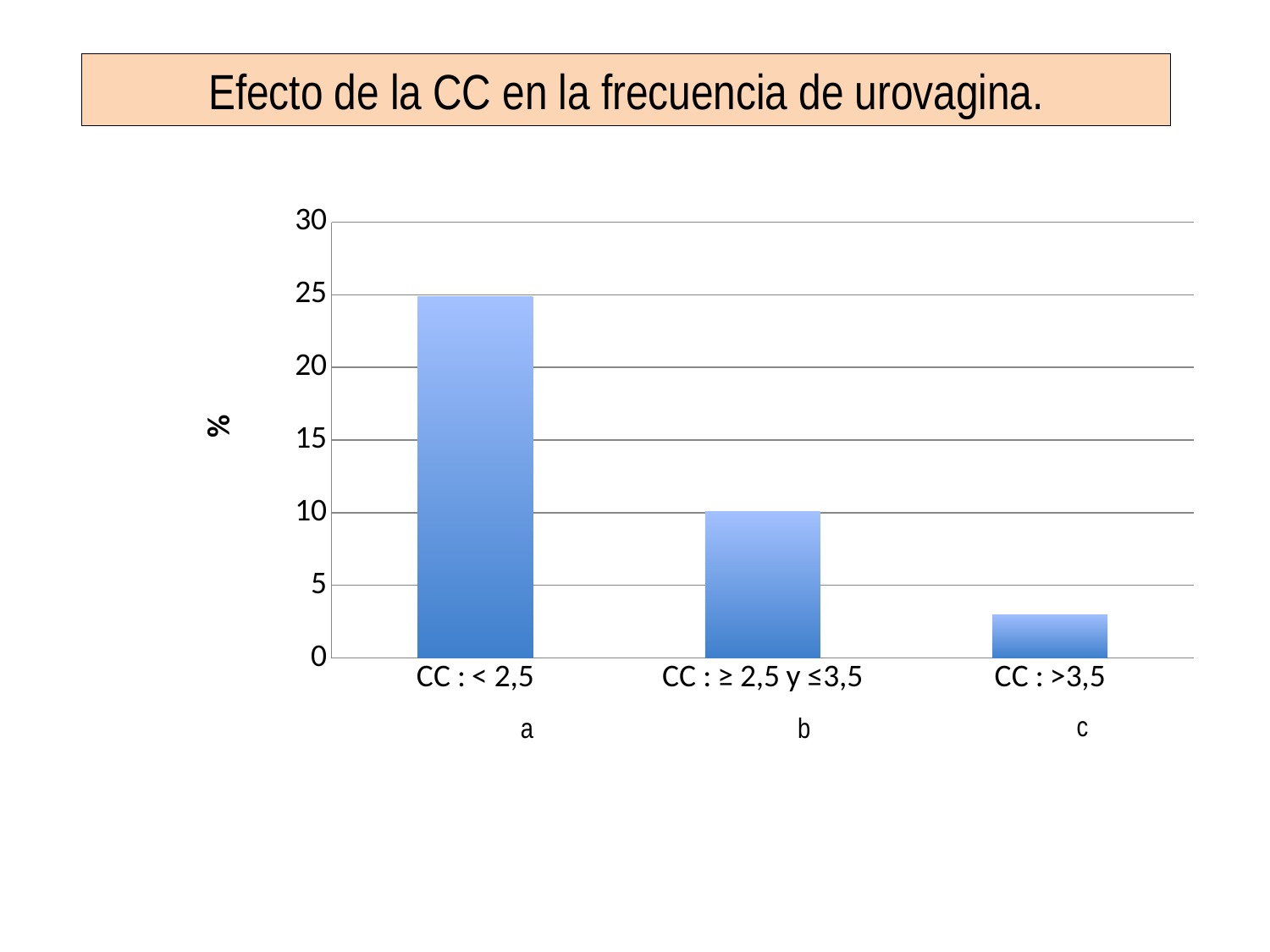
Is the value for CC : < 2,5 greater or less than 20? greater Which is larger, the value for CC : < 2,5 or the value for CC : ≥ 2,5 y ≤3,5? CC : < 2,5 Do the values rise or fall from left to right across the categories? fall Is the value for CC : ≥ 2,5 y ≤3,5 greater or less than 5? greater Which category has the highest value in the chart? CC : < 2,5 What kind of chart is shown on the slide? bar chart What is the title of the slide? Efecto de la CC en la frecuencia de urovagina. How many categories (bars) are plotted in the chart? 3 Which category has the lowest value in the chart? CC : >3,5 Is the value for CC : ≥ 2,5 y ≤3,5 greater or less than 15? less What is the label on the vertical axis of the chart? %